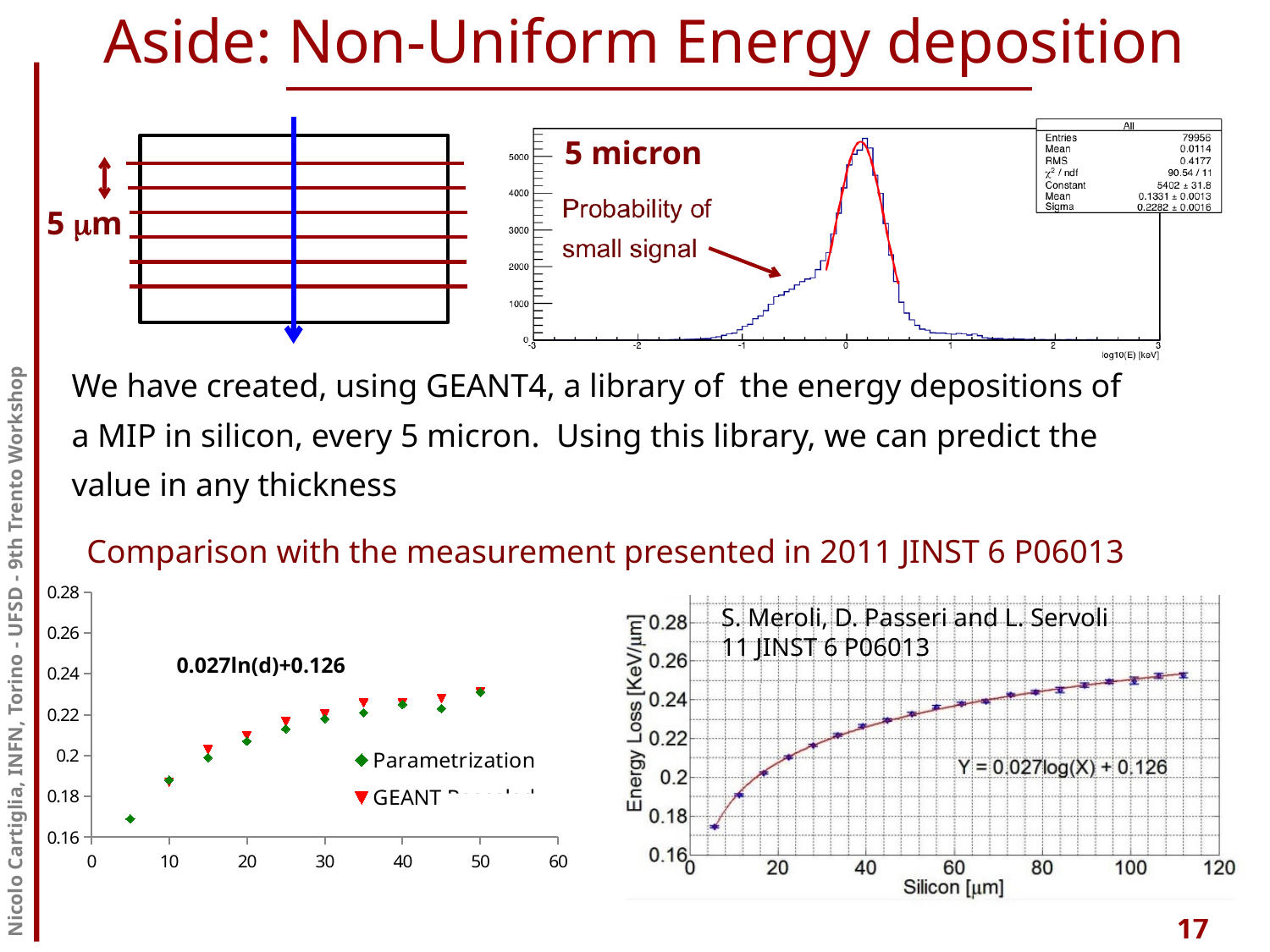
In the bottom-right chart, is the energy loss at 20 μm greater or less than 0.22? less In the bottom-left chart, what formula is printed on the plot area? 0.027ln(d)+0.126 In the bottom-left chart, how many series does the legend list? 2 In the bottom-left chart, do the Parametrization values rise or fall as the x value increases? rise In the bottom-left chart, is the Parametrization value at x = 5 greater or less than 0.18? less In the bottom-right chart, is the energy loss at 100 μm greater or less than 0.24? greater In the bottom-right chart, what is the x-axis label? Silicon [μm] In the top-right '5 micron' histogram, what RMS value is reported in the statistics box? 0.4177 In the top-right '5 micron' histogram, how many entries are reported in the statistics box? 79956 In the bottom-left chart, how many Parametrization (green diamond) points are plotted? 10 In the bottom-left chart, what are the two series named in the legend? Parametrization and GEANT Rescaled